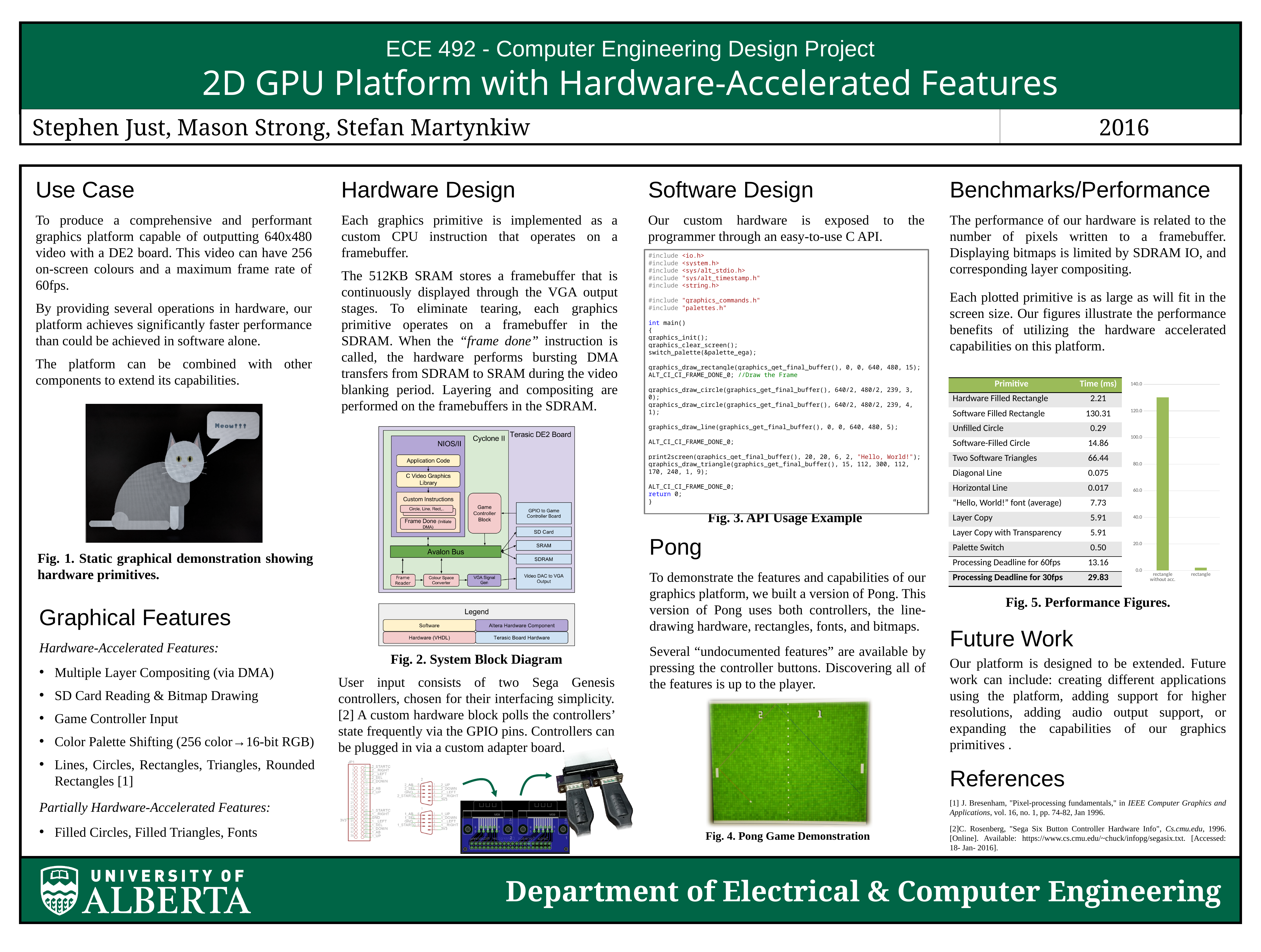
In the Fig. 5 bar chart, is the value for 'rectangle without acc.' greater or less than 120? greater What is the highest tick value shown on the y axis of the Fig. 5 bar chart? 140.0 In the Fig. 5 bar chart, is the value for 'rectangle' greater or less than 20? less In the Fig. 5 bar chart, which is larger: the value for 'rectangle without acc.' or the value for 'rectangle'? rectangle without acc. What kind of chart is shown in Fig. 5 (Performance Figures)? bar chart In the Fig. 5 bar chart, do the values rise or fall from left to right along the x axis? fall How many bars are plotted in the Fig. 5 bar chart? 2 In the Fig. 5 bar chart, which category has the lowest value? rectangle What colour are the bars in the Fig. 5 bar chart? green In the Fig. 5 bar chart, which category has the highest value? rectangle without acc. In the Fig. 5 bar chart, is the value for 'rectangle without acc.' greater or less than 140? less